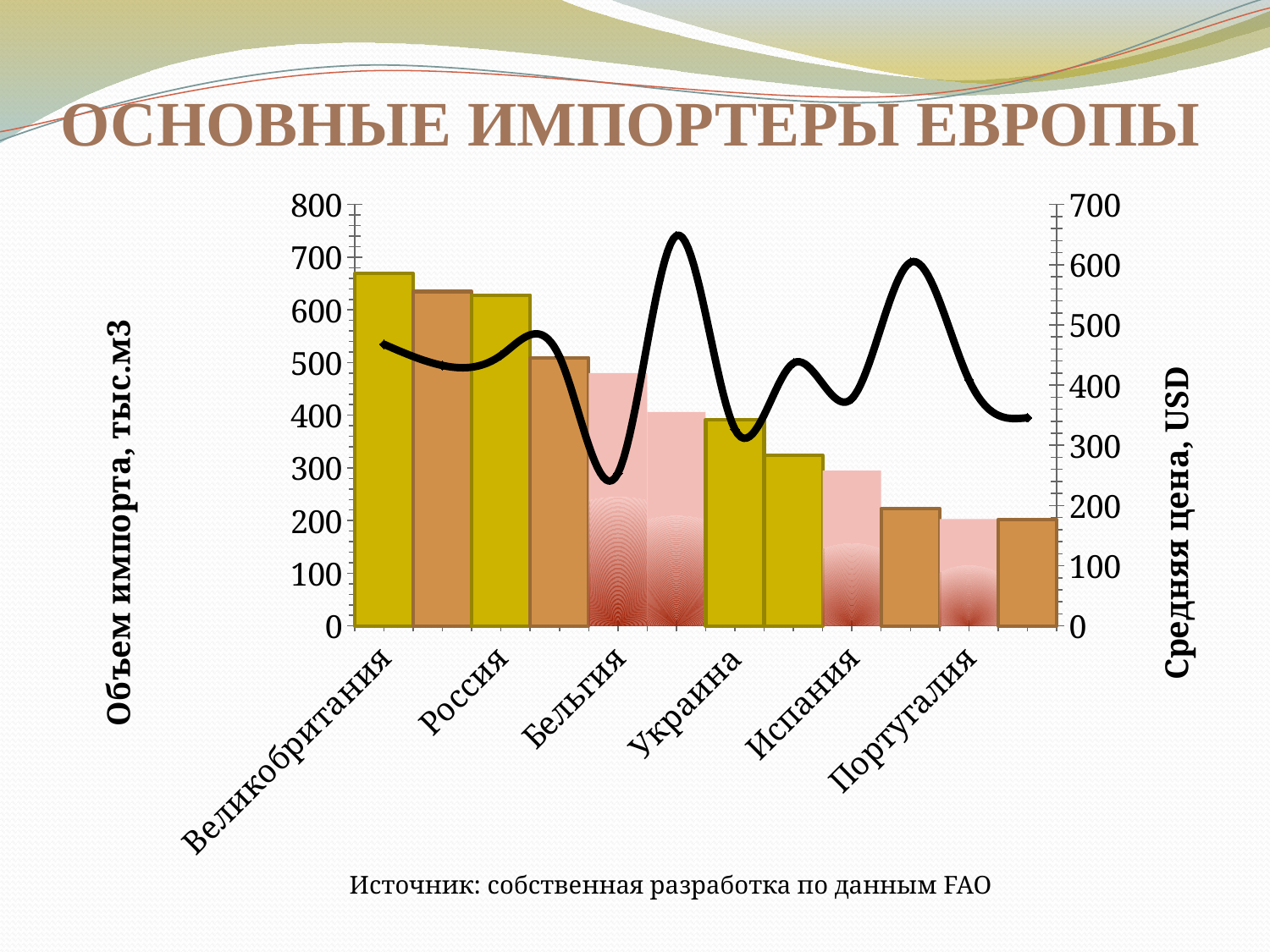
Which is taller, the leftmost bar or the rightmost bar? the leftmost bar Is the value of the rightmost bar greater or less than 300 on the left axis? less Is the lowest point of the line greater or less than 300 on the right axis? less Do the bar heights generally rise or fall from left to right along the x axis? fall What is the title of the right-hand vertical axis? Средняя цена, USD How many country labels are shown on the x axis? 6 What is the title of the chart? ОСНОВНЫЕ ИМПОРТЕРЫ ЕВРОПЫ Is the highest point of the line greater or less than 600 on the right axis? greater How many bars are plotted in the chart? 12 What kind of chart is shown on the slide? bar chart with a line What is the highest tick value shown on the left vertical axis? 800